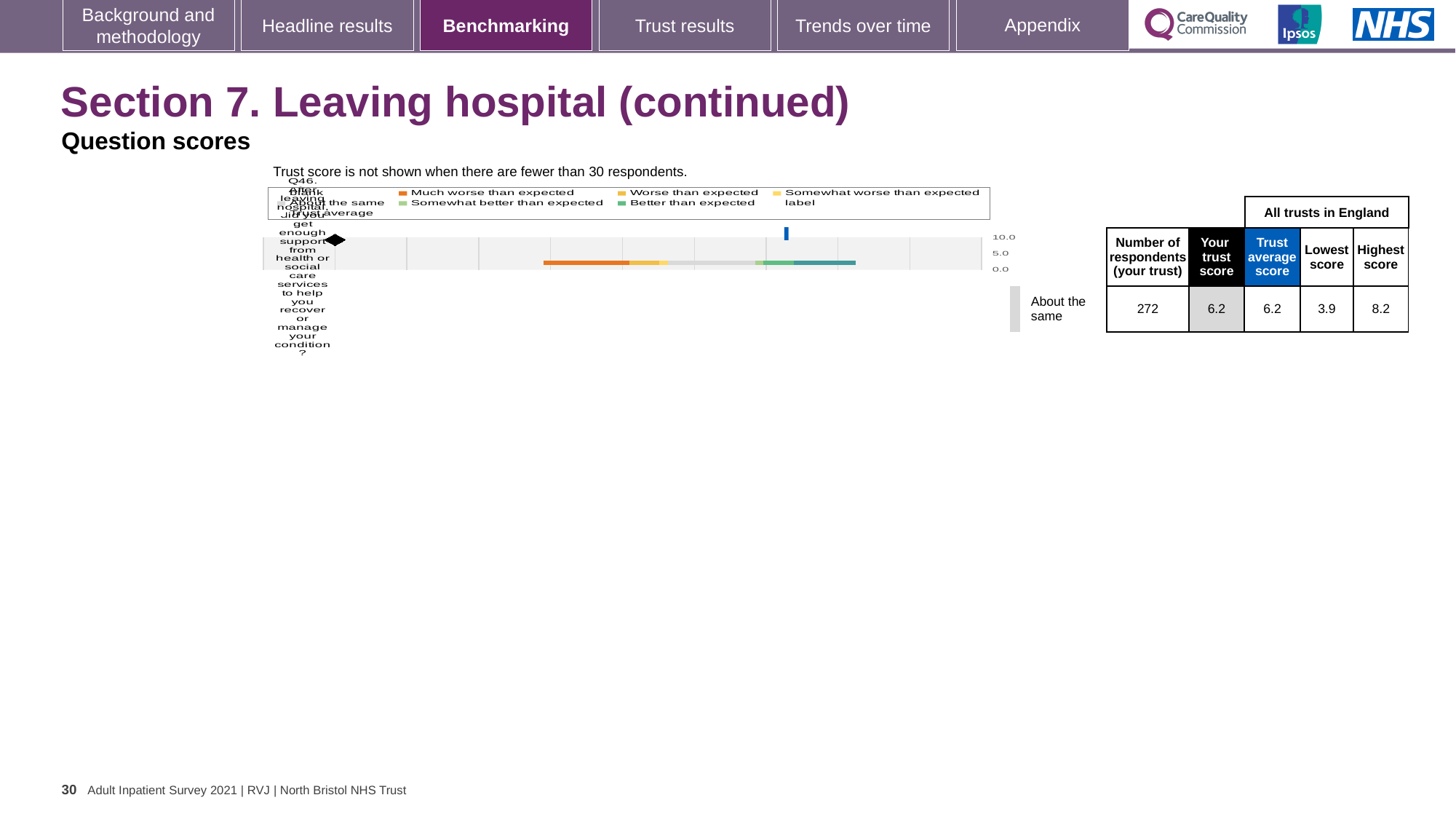
What is the trust average score for Q46? 6.2 What is the difference between the highest score and the lowest score for Q46? 4.3 What is the highest value shown on the chart's x axis? 10.0 What is the lowest score across all trusts in England for Q46? 3.9 How many respondents from your trust answered Q46? 272 Is your trust score for Q46 higher, lower, or the same as the trust average score? the same Which legend entry is shown in orange? Much worse than expected What is the highest score across all trusts in England for Q46? 8.2 What kind of chart is shown on the slide? bar chart How many survey questions are plotted in the chart? 1 What is the 'Your trust score' value for Q46 in the table? 6.2